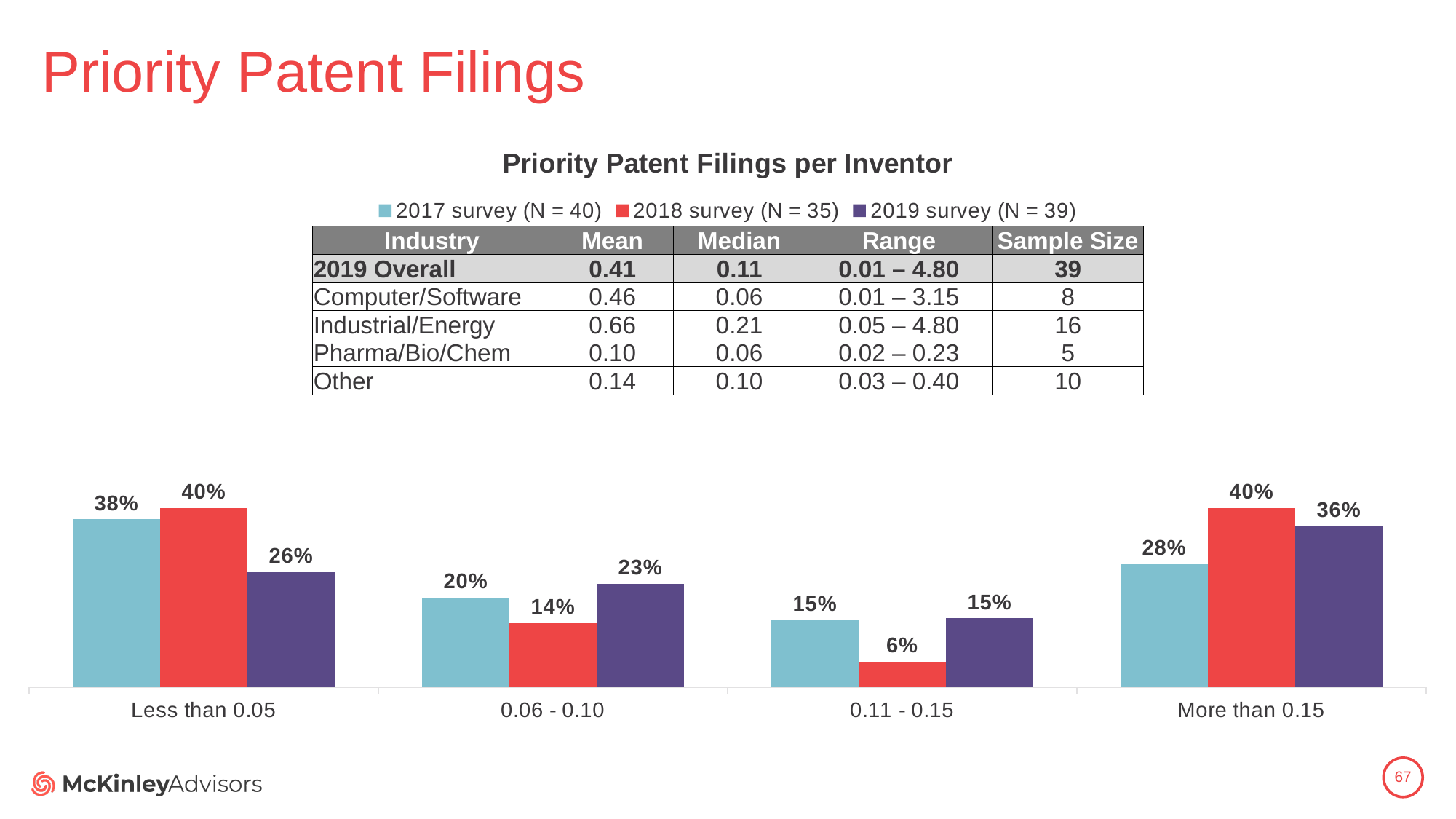
What is the difference between the 2018 survey and 2019 survey values in the 'Less than 0.05' category? 14% How many categories are shown on the x axis of the chart? 4 What is the title of the chart? Priority Patent Filings per Inventor What is the value for the 2017 survey in the 'Less than 0.05' category? 38% What kind of chart is shown on the slide? Bar chart Which is larger in the '0.06 - 0.10' category: the 2017 survey value or the 2019 survey value? 2019 survey What is the sample size (N) for the 2018 survey according to the legend? 35 Which category has the lowest value for the 2018 survey? 0.11 - 0.15 What is the value for the 2019 survey in the 'More than 0.15' category? 36% What is the value for the 2018 survey in the '0.11 - 0.15' category? 6% Which category has the highest value for the 2019 survey? More than 0.15 How many series does the chart legend list? 3